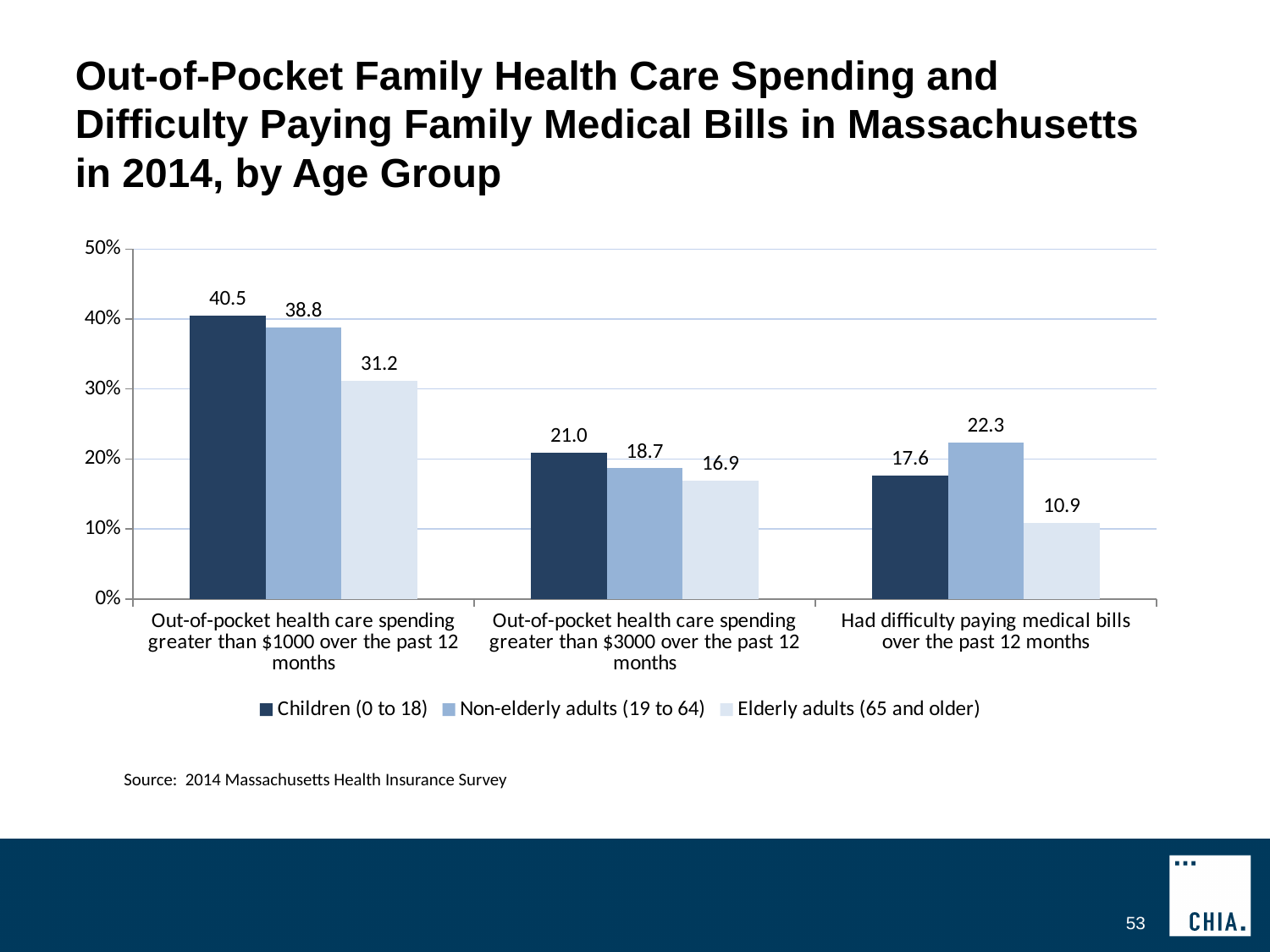
What is the value for Children (0 to 18) for out-of-pocket health care spending greater than $1000 over the past 12 months? 40.5 Which age group has the lowest value for out-of-pocket health care spending greater than $1000 over the past 12 months? Elderly adults (65 and older) What is the difference between the Non-elderly adults (19 to 64) and Children (0 to 18) values for having difficulty paying medical bills over the past 12 months? 4.7 What is the difference between the Children (0 to 18) and Elderly adults (65 and older) values for out-of-pocket health care spending greater than $1000 over the past 12 months? 9.3 What is the value for Elderly adults (65 and older) for having difficulty paying medical bills over the past 12 months? 10.9 What kind of chart is shown on the slide? Bar chart How many categories are shown on the x axis? 3 Which age group has the highest value for having difficulty paying medical bills over the past 12 months? Non-elderly adults (19 to 64) What is the value for Non-elderly adults (19 to 64) for out-of-pocket health care spending greater than $3000 over the past 12 months? 18.7 How many series does the legend list? 3 Is the value for Elderly adults (65 and older) for out-of-pocket spending greater than $1000 greater or less than 30%? greater Which is larger: the Children (0 to 18) value for spending greater than $3000 or the Children (0 to 18) value for having difficulty paying medical bills? Spending greater than $3000 (21.0)